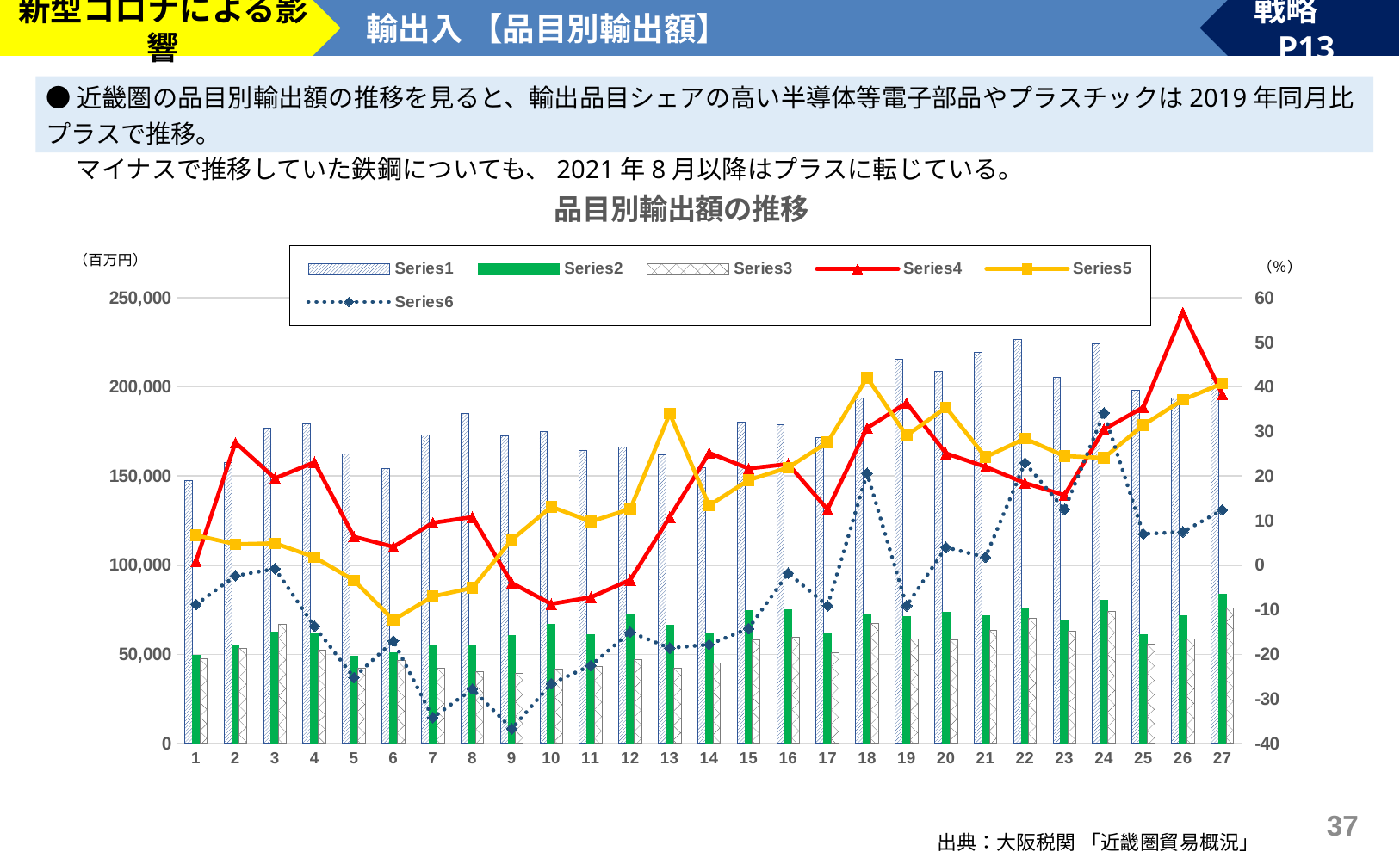
How many categories are shown along the x axis of the chart? 27 At category 13, which is larger: Series4 or Series5? Series5 Is the value of Series1 at category 22 greater or less than 200,000? greater At which category does Series6 reach its highest value? 24 Does Series5 rise or fall from category 1 to category 6? fall At which category does Series4 reach its highest value? 26 What kind of chart is shown on the slide? Combination bar and line chart Is the value of Series4 at category 26 greater or less than 50? greater What is the title of the chart? 品目別輸出額の推移 How many series does the chart legend list? 6 Is the value of Series6 at category 9 greater or less than -30? less What unit is shown for the left vertical axis of the chart? 百万円